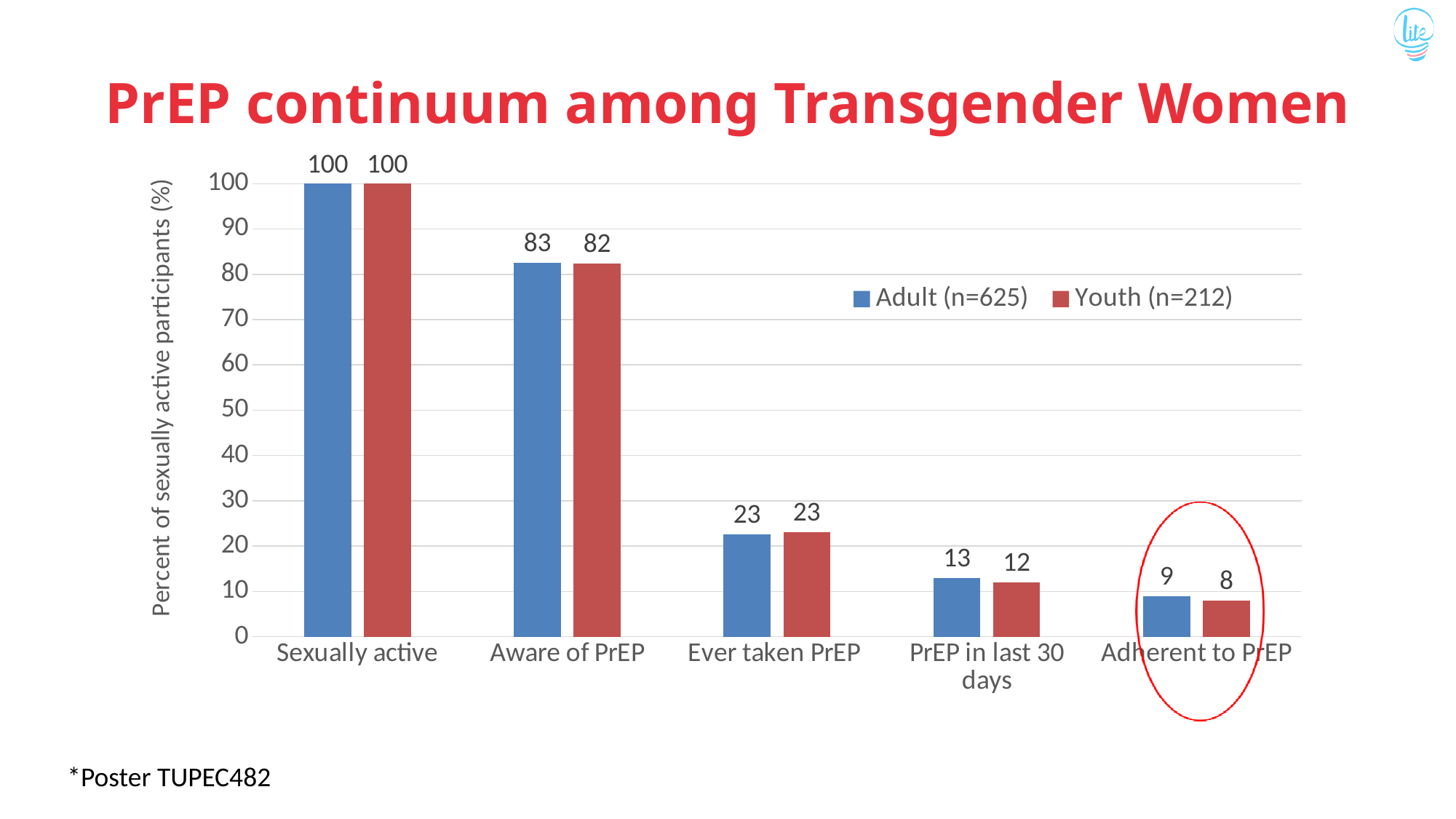
What is the difference between the Adult (n=625) values for Aware of PrEP and Ever taken PrEP? 60 What is the difference between the Adult and Youth values in the Adherent to PrEP category? 1 Which category has the highest value for the Youth (n=212) series? Sexually active How many series does the legend list? 2 What is the value for Youth (n=212) in the PrEP in last 30 days category? 12 How many categories are shown on the x axis? 5 What kind of chart is shown on the slide? Bar chart What is the value for Adult (n=625) in the Aware of PrEP category? 83 Which is larger: the Adult value for Ever taken PrEP or the Youth value for PrEP in last 30 days? Adult value for Ever taken PrEP Do the Adult (n=625) values rise or fall from left to right along the x axis? Fall Which category has the lowest value for the Adult (n=625) series? Adherent to PrEP What is the value for Youth (n=212) in the Adherent to PrEP category? 8